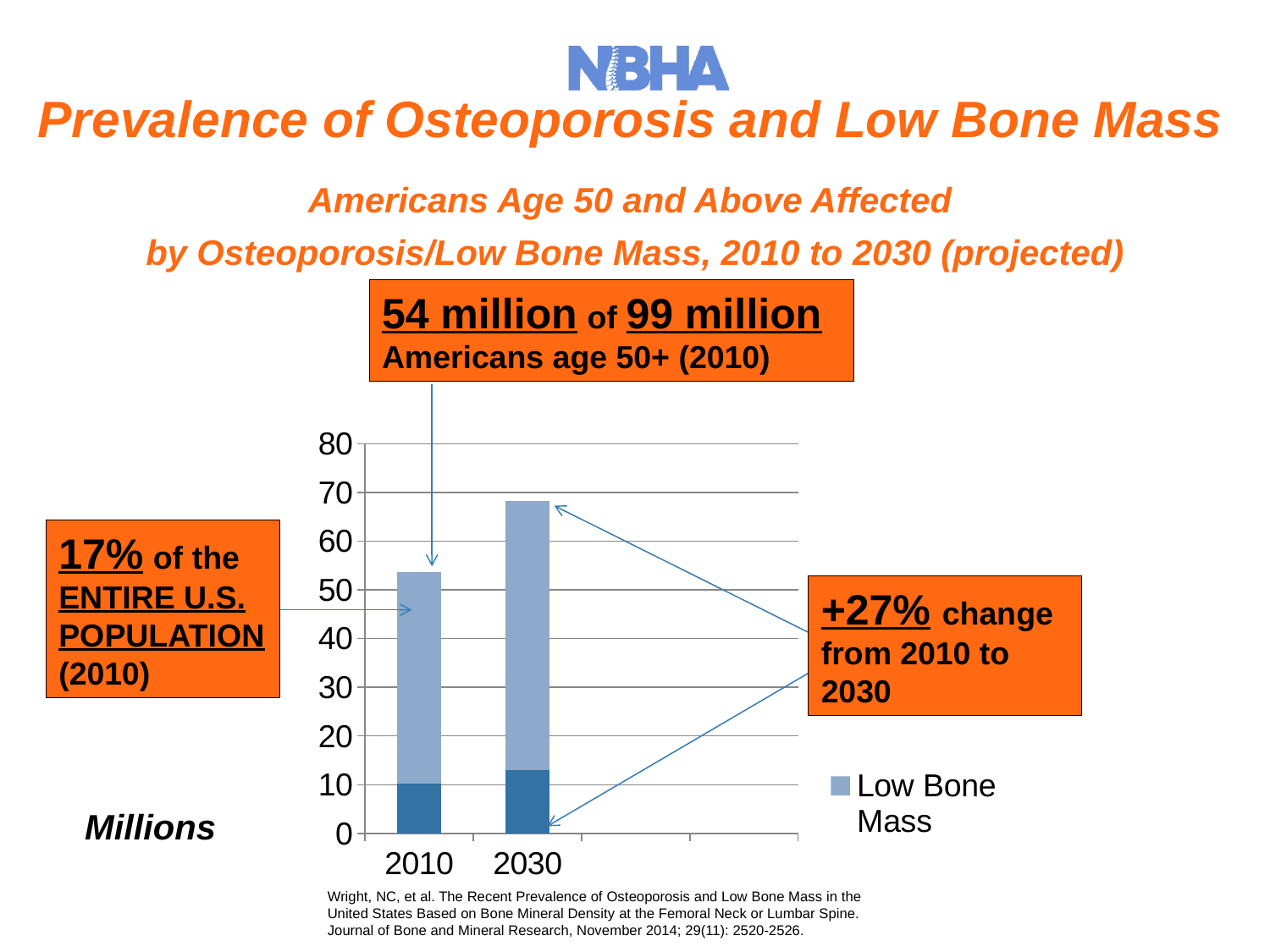
Which year has the taller stacked bar, 2010 or 2030? 2030 Is the dark blue segment of the 2030 bar greater or less than 20? less According to the callout pointing to the 2010 bar, how many Americans age 50+ were affected in 2010? 54 million What percentage change from 2010 to 2030 does the callout on the chart state? +27% Do the stacked bar totals rise or fall from 2010 to 2030? rise Is the total height of the 2010 bar greater or less than 50? greater Is the total height of the 2030 bar greater or less than 70? less What series name is shown in the chart legend? Low Bone Mass How many years (categories) are plotted on the x axis of the chart? 2 Is the light blue (Low Bone Mass) segment larger in 2010 or in 2030? 2030 What kind of chart is shown on the slide? bar chart